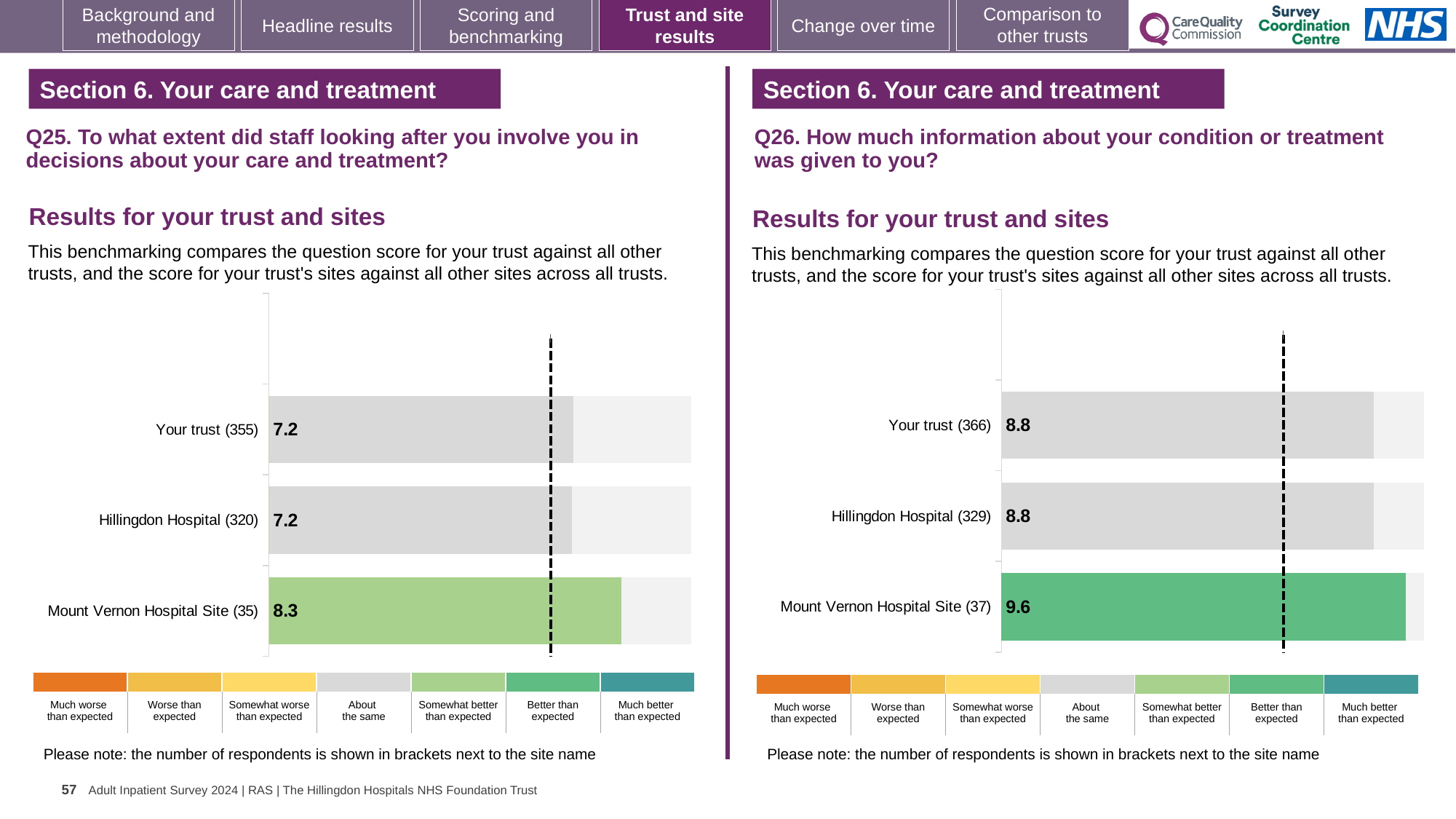
In the Q25 chart on the left, what is the score for Mount Vernon Hospital Site? 8.3 In the Q26 chart on the right, how many respondents are shown in brackets for Mount Vernon Hospital Site? 37 How many bars are shown in the Q25 chart on the left? 3 In the Q25 chart on the left, which site or trust has the highest score? Mount Vernon Hospital Site In the Q26 chart on the right, what is the score for Hillingdon Hospital? 8.8 In the Q25 chart on the left, what is the difference between the Mount Vernon Hospital Site score and the Your trust score? 1.1 In the Q26 chart on the right, what is the difference between the Mount Vernon Hospital Site score and the Hillingdon Hospital score? 0.8 In the Q25 chart on the left, what is the score for Your trust? 7.2 In the Q26 chart on the right, which site or trust has the highest score? Mount Vernon Hospital Site In the Q26 chart on the right, which has the larger score, Your trust or Mount Vernon Hospital Site? Mount Vernon Hospital Site In the Q26 chart on the right, what is the score for Mount Vernon Hospital Site? 9.6 What type of chart is used for the Q26 results on the right? Bar chart